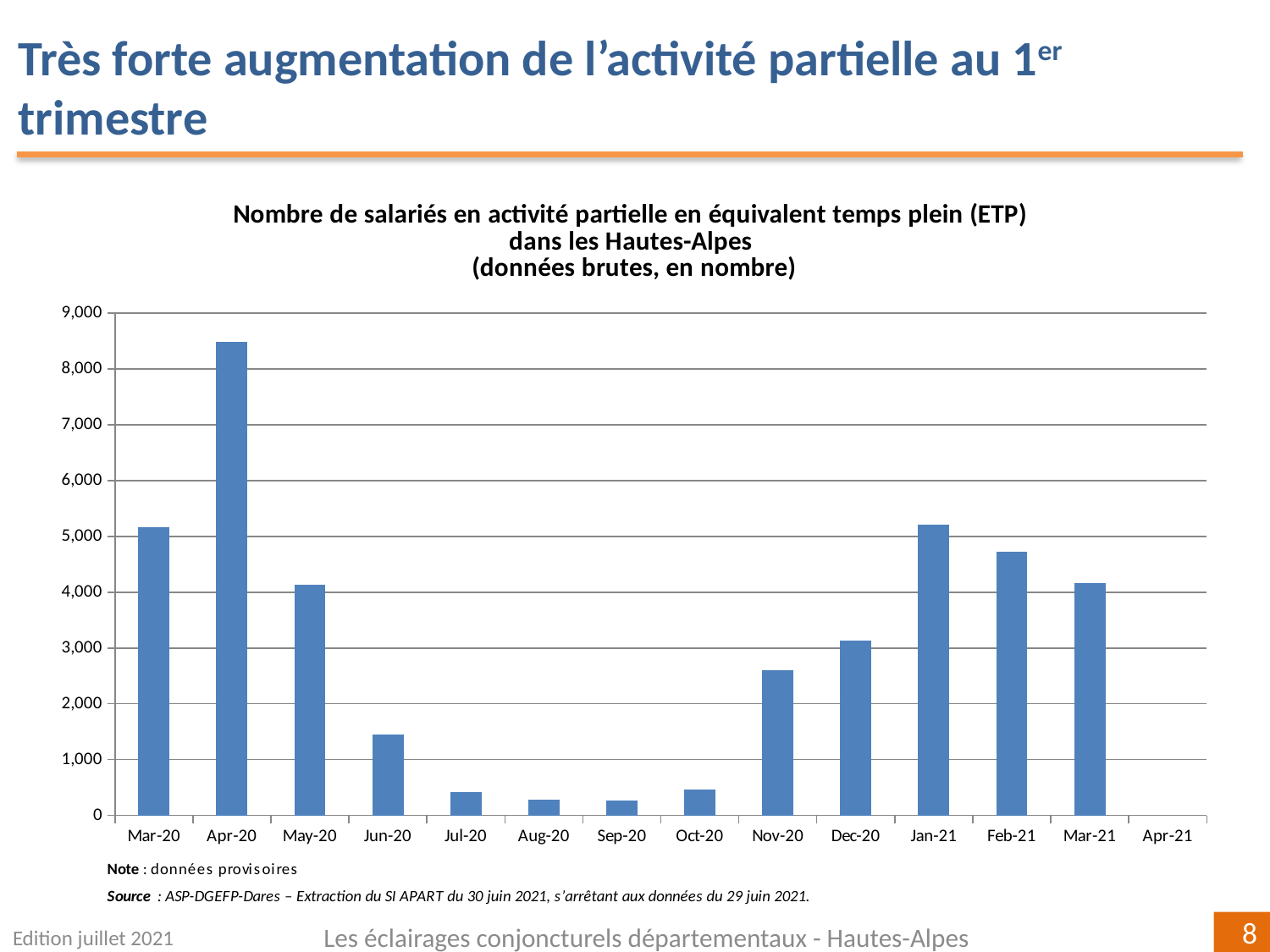
Is the value for Feb-21 greater or less than 5,000? less What kind of chart is shown on the slide? bar chart Do the values rise or fall from Apr-20 to Sep-20? fall Is the value for Apr-20 greater or less than 8,000? greater According to the chart title, which département does the data cover? Hautes-Alpes Is the value for Nov-20 greater or less than 2,000? greater How many months are labelled on the x axis? 14 Which is larger, the value for Nov-20 or the value for Dec-20? Dec-20 Which is larger, the value for Jun-20 or the value for Jul-20? Jun-20 Which is larger, the value for Jan-21 or the value for Feb-21? Jan-21 Which month has the highest number of salariés en activité partielle? Apr-20